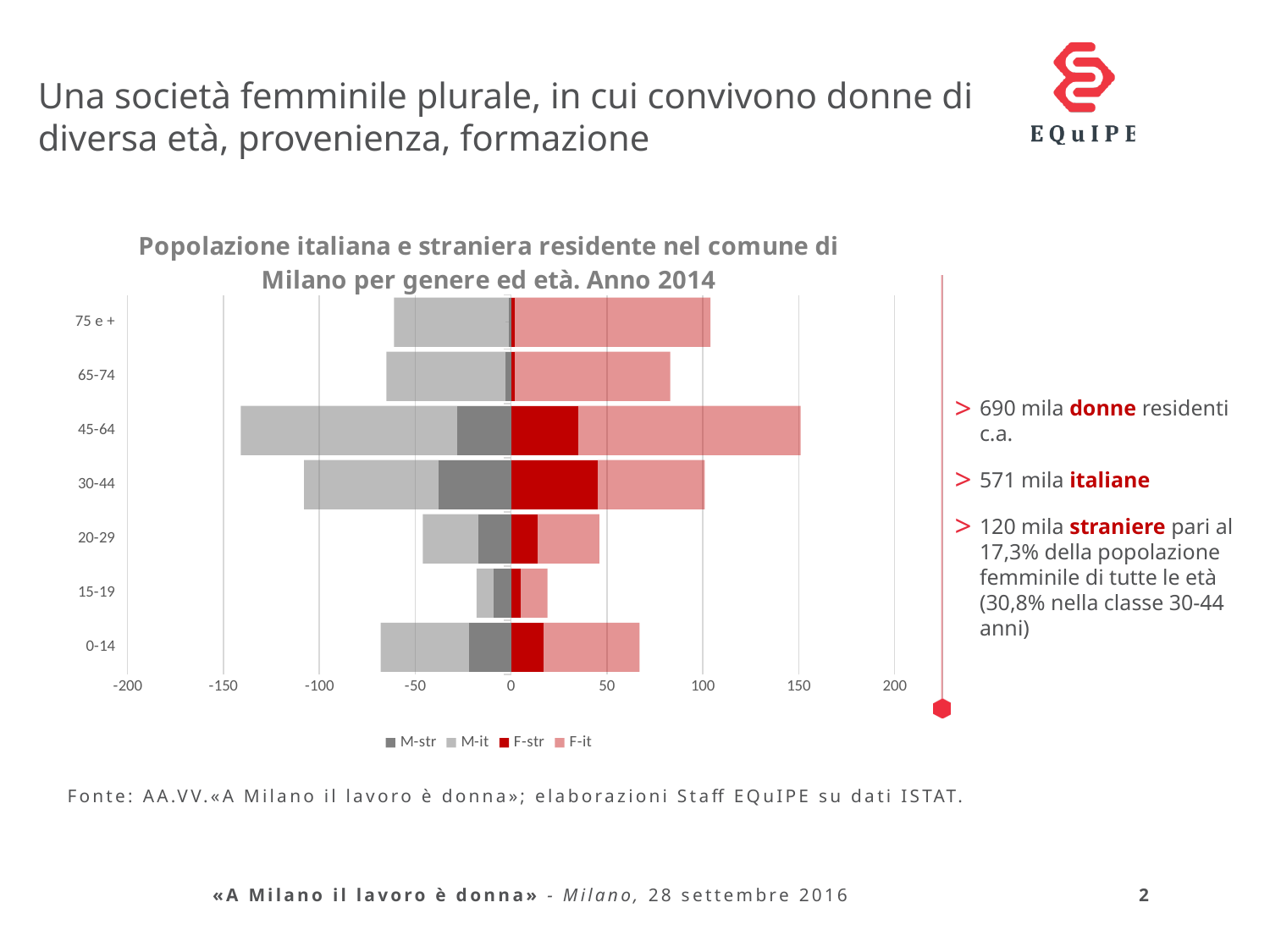
Which age group has a larger F-it value, 0-14 or 20-29? 0-14 Which series are listed in the chart legend? M-str, M-it, F-str, F-it Which age group has the longest F-str bar? 30-44 How many series does the chart legend list? 4 Which age group has the shortest F-it bar? 15-19 What kind of chart is shown on the slide? bar chart Is the F-it value for the 65-74 age group greater or less than 50? greater How many age groups are shown on the chart's vertical axis? 7 Is the F-it value for the 65-74 age group greater or less than 100? less Is the F-str value for the 45-64 age group greater or less than 50? less Which age group has the longest F-it bar? 45-64 What is the title of the chart? Popolazione italiana e straniera residente nel comune di Milano per genere ed età. Anno 2014